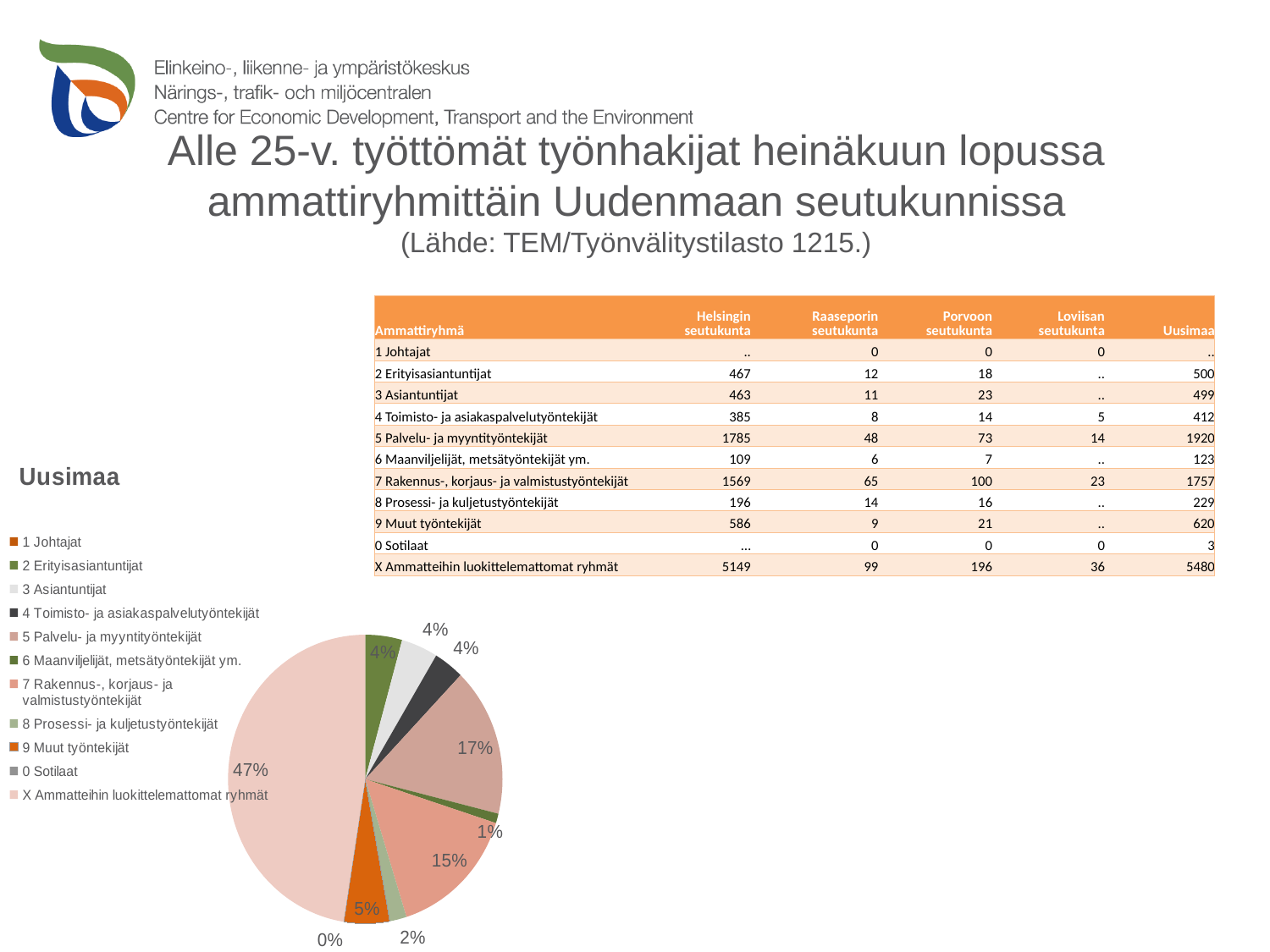
What kind of chart is shown on the slide? pie chart What share of the pie does '0 Sotilaat' have? 0% What share of the pie does 'X Ammatteihin luokittelemattomat ryhmät' have? 47% What share of the pie does '9 Muut työntekijät' have? 5% Which category has the largest slice of the pie? X Ammatteihin luokittelemattomat ryhmät What is the title of the pie chart? Uusimaa Which is larger in the pie chart: '5 Palvelu- ja myyntityöntekijät' or '7 Rakennus-, korjaus- ja valmistustyöntekijät'? 5 Palvelu- ja myyntityöntekijät What is the difference in percentage points between the 'X Ammatteihin luokittelemattomat ryhmät' slice and the '5 Palvelu- ja myyntityöntekijät' slice? 30 percentage points How many entries does the pie chart's legend list? 11